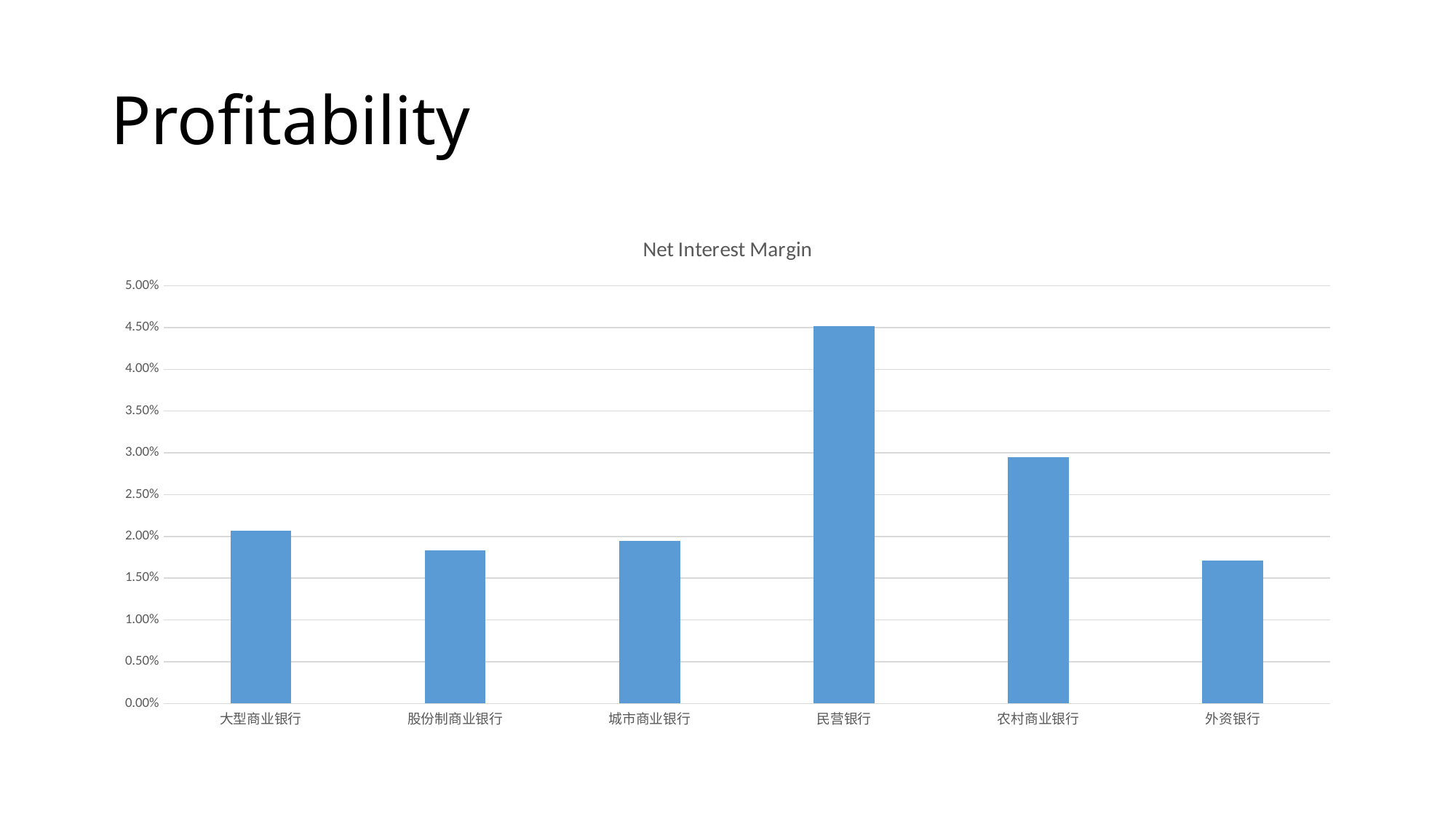
Which bank category has the highest net interest margin? 民营银行 Which bank category has the lowest net interest margin? 外资银行 Is the net interest margin for 农村商业银行 greater or less than 2.50%? greater Which has a higher net interest margin, 农村商业银行 or 城市商业银行? 农村商业银行 How many bank categories are shown on the x axis of the chart? 6 Is the net interest margin for 股份制商业银行 greater or less than 2.00%? less What is the title of the chart? Net Interest Margin What is the highest value shown on the y axis of the chart? 5.00% Which has a higher net interest margin, 大型商业银行 or 股份制商业银行? 大型商业银行 Is the net interest margin for 民营银行 greater or less than 4.00%? greater What type of chart is shown on the slide? bar chart